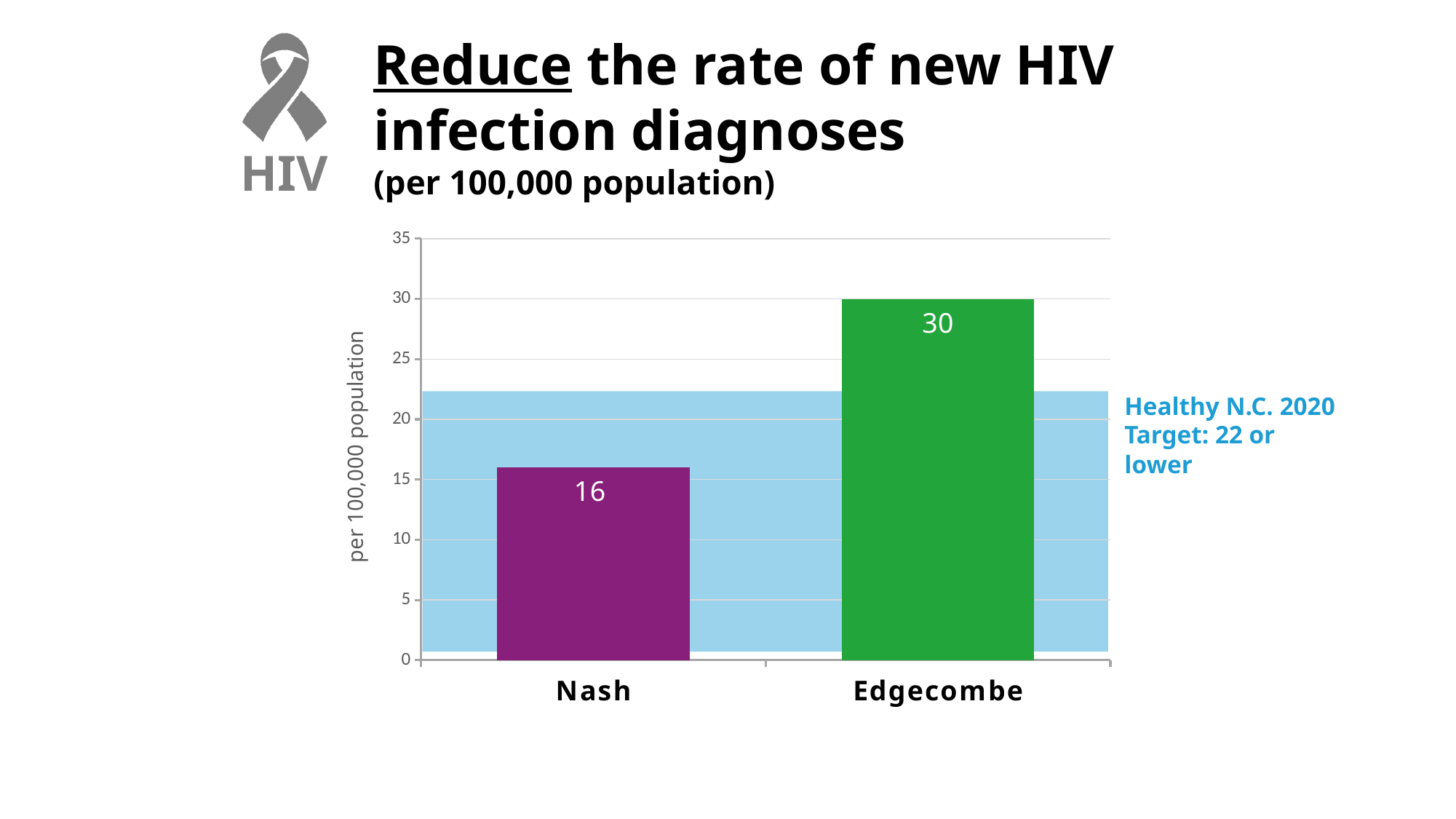
What kind of chart is shown on the slide? Bar chart What is the rate of new HIV infection diagnoses for Nash? 16 What is the difference between the Edgecombe and Nash rates? 14 Is the value for Nash greater or less than the Healthy N.C. 2020 target of 22? less Which county has the higher rate of new HIV infection diagnoses? Edgecombe Is the value for Edgecombe greater or less than 25? greater What is the Healthy N.C. 2020 target shown on the chart? 22 or lower Is the value for Nash greater or less than 20? less What is the label on the vertical axis? per 100,000 population How many counties are shown in the chart? 2 Which county has the lower rate of new HIV infection diagnoses? Nash What is the rate of new HIV infection diagnoses for Edgecombe? 30